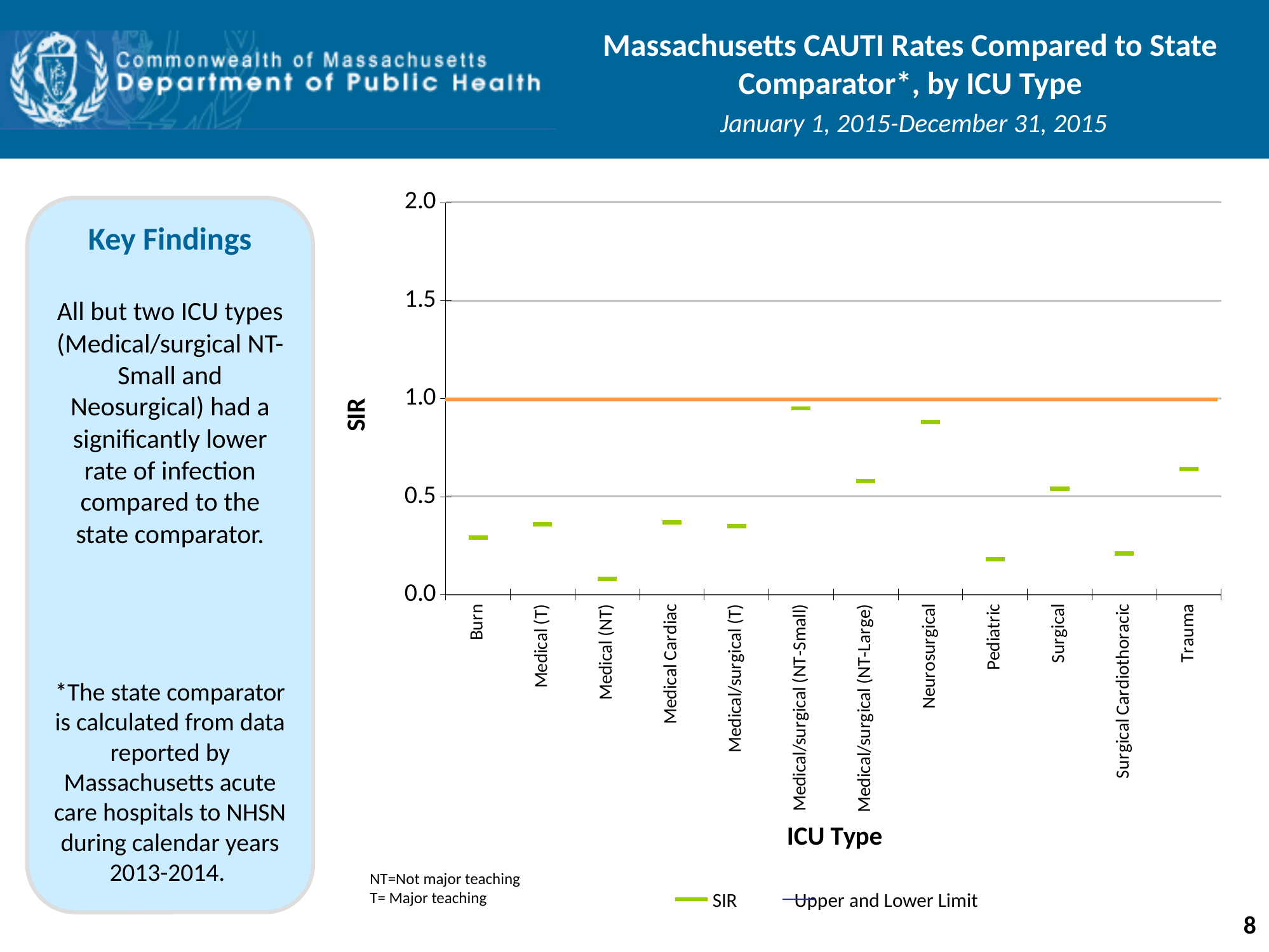
Is the SIR value for Pediatric greater or less than 0.5? less Is the SIR value for Medical/surgical (NT-Small) greater or less than 1.0? less Which has the larger SIR value, Neurosurgical or Burn? Neurosurgical What is the label of the y axis of the chart? SIR Which ICU type has the lowest SIR value in the chart? Medical (NT) Which has the larger SIR value, Trauma or Surgical? Trauma How many series does the chart legend list? 2 Is the SIR value for Burn greater or less than 0.5? less Which ICU type has the highest SIR value in the chart? Medical/surgical (NT-Small) How many ICU types are plotted along the x axis of the chart? 12